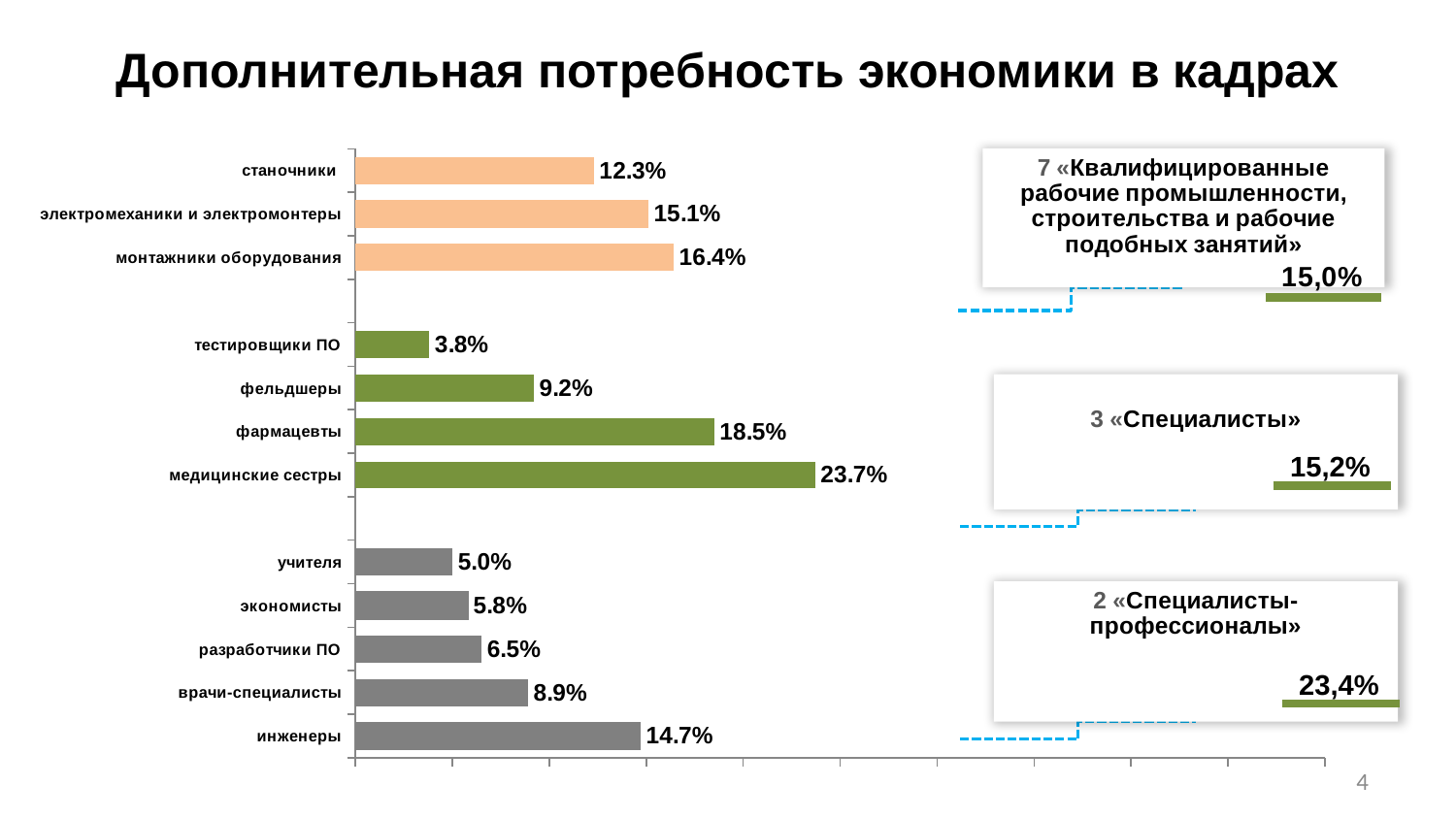
Which category has the highest value? медицинские сестры What is the difference between the values for инженеры and врачи-специалисты? 5.8% Which category has the lowest value? тестировщики ПО What is the title of the slide? Дополнительная потребность экономики в кадрах What kind of chart is shown on the slide? bar chart What is the difference between the values for фармацевты and фельдшеры? 9.3% Which is larger, the value for электромеханики и электромонтеры or the value for станочники? электромеханики и электромонтеры What is the value for инженеры? 14.7% What is the value for медицинские сестры? 23.7% What is the value for монтажники оборудования? 16.4% What is the value for тестировщики ПО? 3.8% How many categories are shown in the bar chart? 12